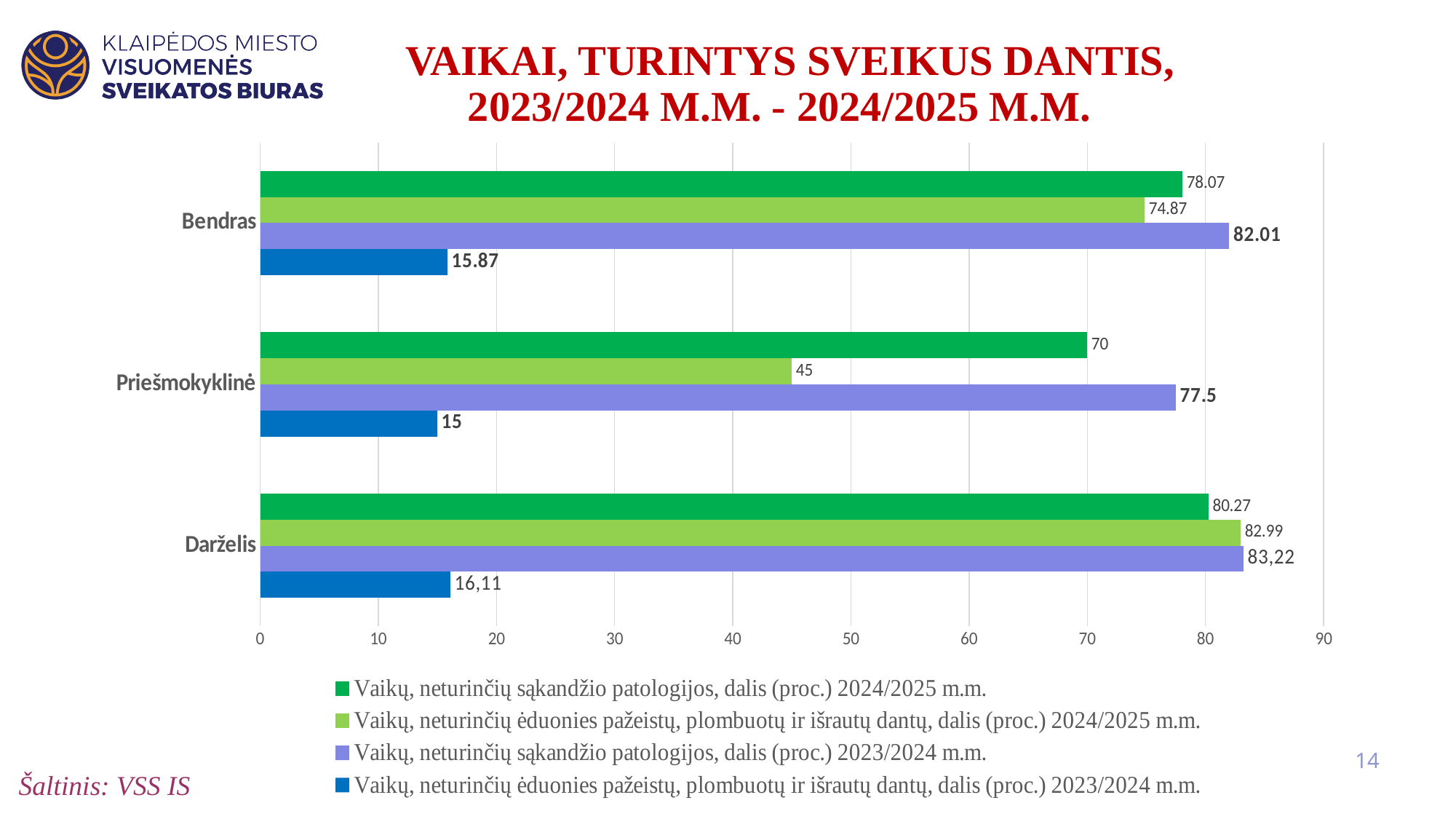
What is the value for Priešmokyklinė in the series 'Vaikų, neturinčių sąkandžio patologijos, dalis (proc.) 2024/2025 m.m.'? 70 What type of chart is shown on the slide? bar chart What is the value for Bendras in the series 'Vaikų, neturinčių sąkandžio patologijos, dalis (proc.) 2023/2024 m.m.'? 82.01 What is the source cited at the bottom of the slide? VSS IS For Priešmokyklinė, which is larger: the 2024/2025 value for 'Vaikų, neturinčių sąkandžio patologijos' or the 2024/2025 value for 'Vaikų, neturinčių ėduonies pažeistų, plombuotų ir išrautų dantų'? Vaikų, neturinčių sąkandžio patologijos, dalis (proc.) 2024/2025 m.m. What is the value for Darželis in the series 'Vaikų, neturinčių ėduonies pažeistų, plombuotų ir išrautų dantų, dalis (proc.) 2023/2024 m.m.'? 16,11 What is the value for Priešmokyklinė in the series 'Vaikų, neturinčių ėduonies pažeistų, plombuotų ir išrautų dantų, dalis (proc.) 2024/2025 m.m.'? 45 Which category has the lowest value in the series 'Vaikų, neturinčių sąkandžio patologijos, dalis (proc.) 2023/2024 m.m.'? Priešmokyklinė Which category has the highest value in the series 'Vaikų, neturinčių ėduonies pažeistų, plombuotų ir išrautų dantų, dalis (proc.) 2024/2025 m.m.'? Darželis How many series does the legend list? 4 How many categories are shown on the vertical axis? 3 What is the difference between the Bendras values for 'Vaikų, neturinčių sąkandžio patologijos, dalis (proc.) 2023/2024 m.m.' and 'Vaikų, neturinčių sąkandžio patologijos, dalis (proc.) 2024/2025 m.m.'? 3.94